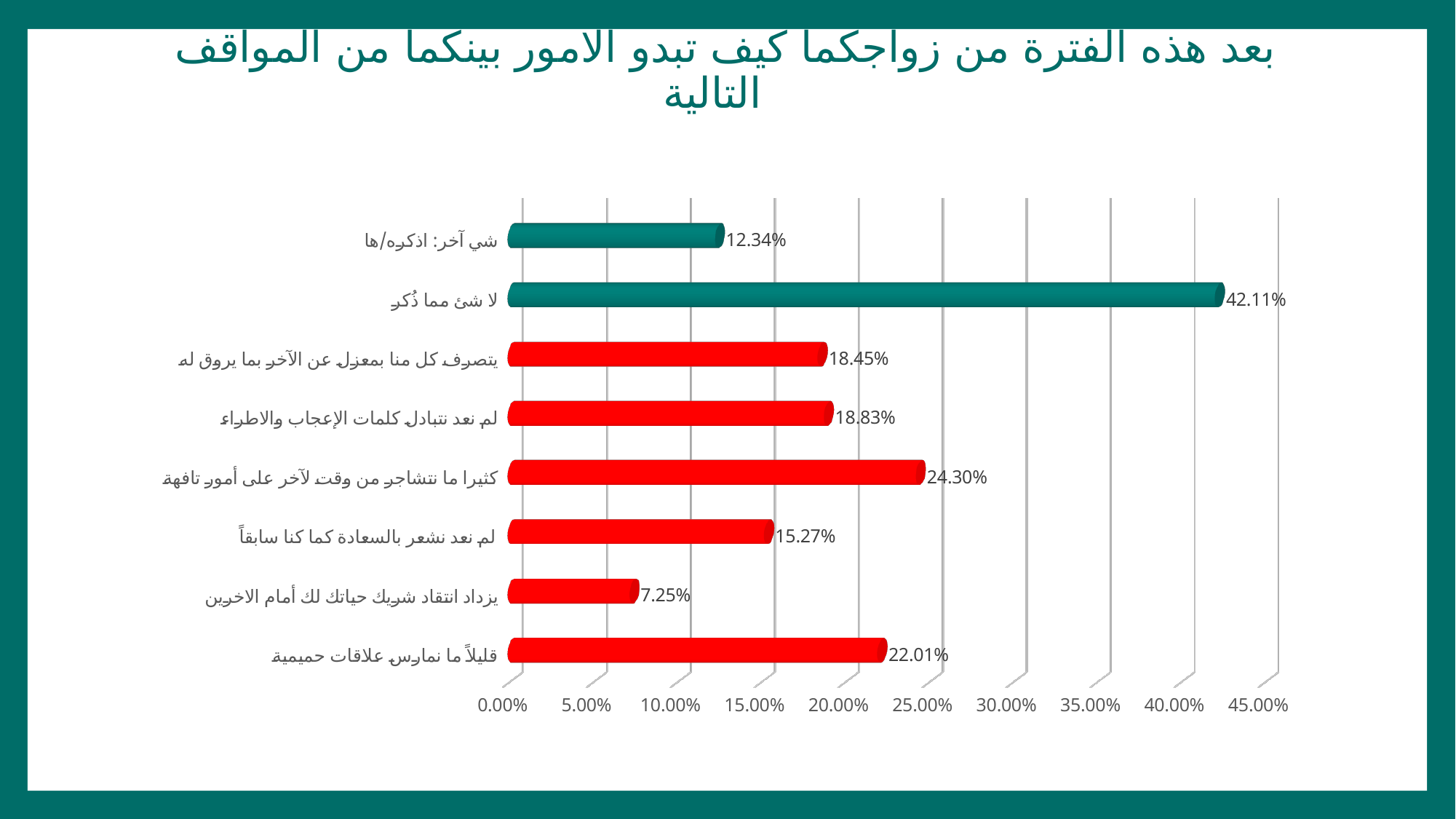
Which category has the highest value? لا شئ مما ذُكر Which is larger: the value for "كثيرا ما نتشاجر من وقت لآخر على أمور تافهة" or the value for "لم نعد نشعر بالسعادة كما كنا سابقاً"? كثيرا ما نتشاجر من وقت لآخر على أمور تافهة What is the value for "كثيرا ما نتشاجر من وقت لآخر على أمور تافهة"? 24.30% Is the value for "لم نعد نتبادل كلمات الإعجاب والاطراء" greater or less than 20.00%? less How many categories are plotted in the chart? 8 What is the maximum value shown on the horizontal axis? 45.00% What is the value for "لا شئ مما ذُكر"? 42.11% What is the value for "يزداد انتقاد شريك حياتك لك أمام الاخرين"? 7.25% What type of chart is shown on the slide? Bar chart What is the difference between the values for "لا شئ مما ذُكر" and "شي آخر: اذكره/ها"? 29.77% Which category has the lowest value? يزداد انتقاد شريك حياتك لك أمام الاخرين What is the value for "قليلاً ما نمارس علاقات حميمية"? 22.01%